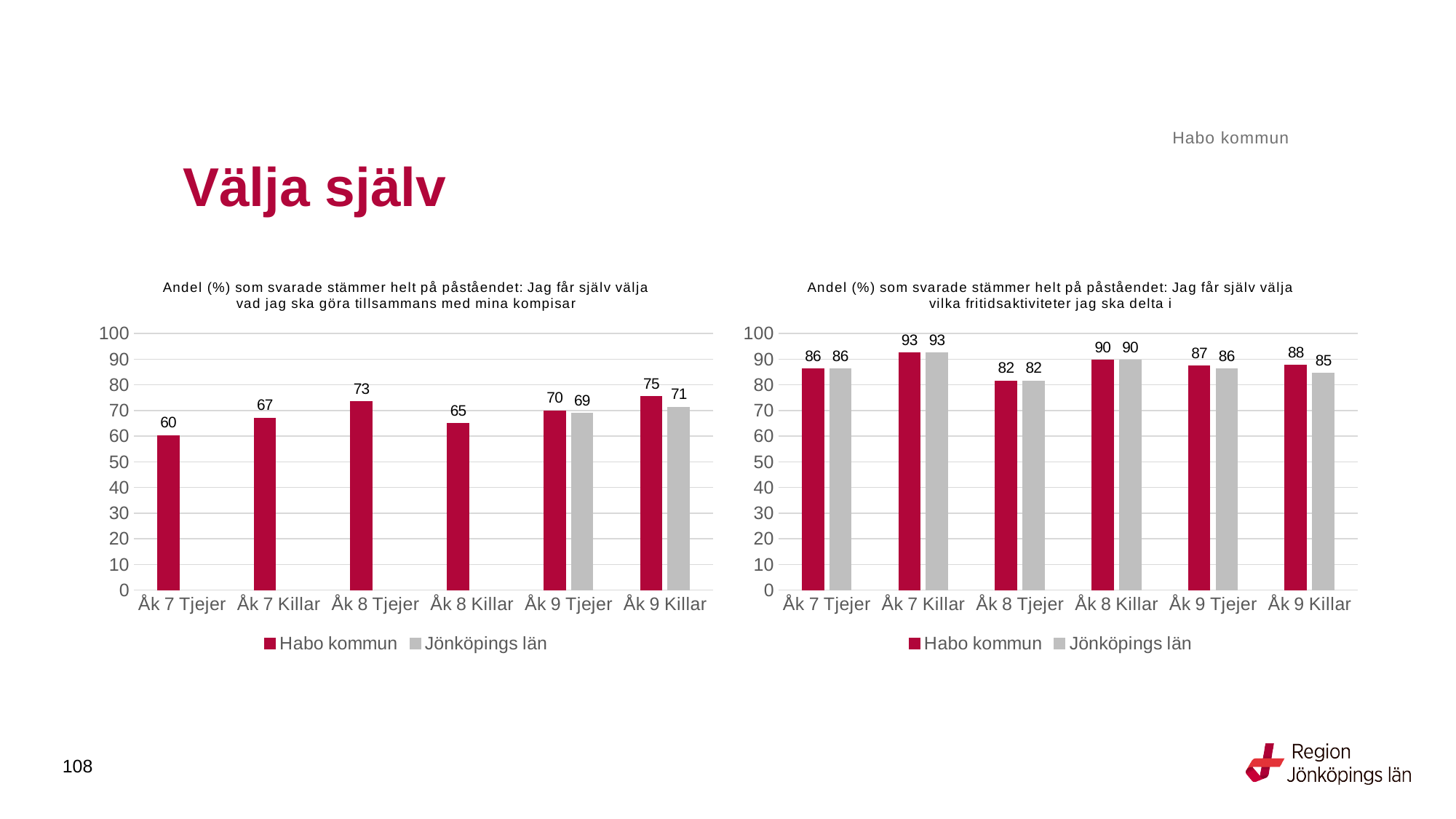
In the left chart, what is the value for Habo kommun for Åk 8 Tjejer? 73 In the right chart, which is larger for Åk 9 Killar: Habo kommun or Jönköpings län? Habo kommun In the left chart, what is the Jönköpings län value for Åk 9 Tjejer? 69 What kind of chart is the right chart? Bar chart In the right chart, which category has the lowest Jönköpings län value? Åk 8 Tjejer In the left chart, what is the difference between the Habo kommun values for Åk 8 Tjejer and Åk 8 Killar? 8 In the right chart, what is the difference between the Habo kommun and Jönköpings län values for Åk 9 Killar? 3 In the left chart, which category has the highest Habo kommun value? Åk 9 Killar How many series does the legend of the left chart list? 2 How many categories are shown on the x axis of the right chart? 6 In the right chart, what is the value for Habo kommun for Åk 7 Killar? 93 In the left chart, which category has the lowest Habo kommun value? Åk 7 Tjejer